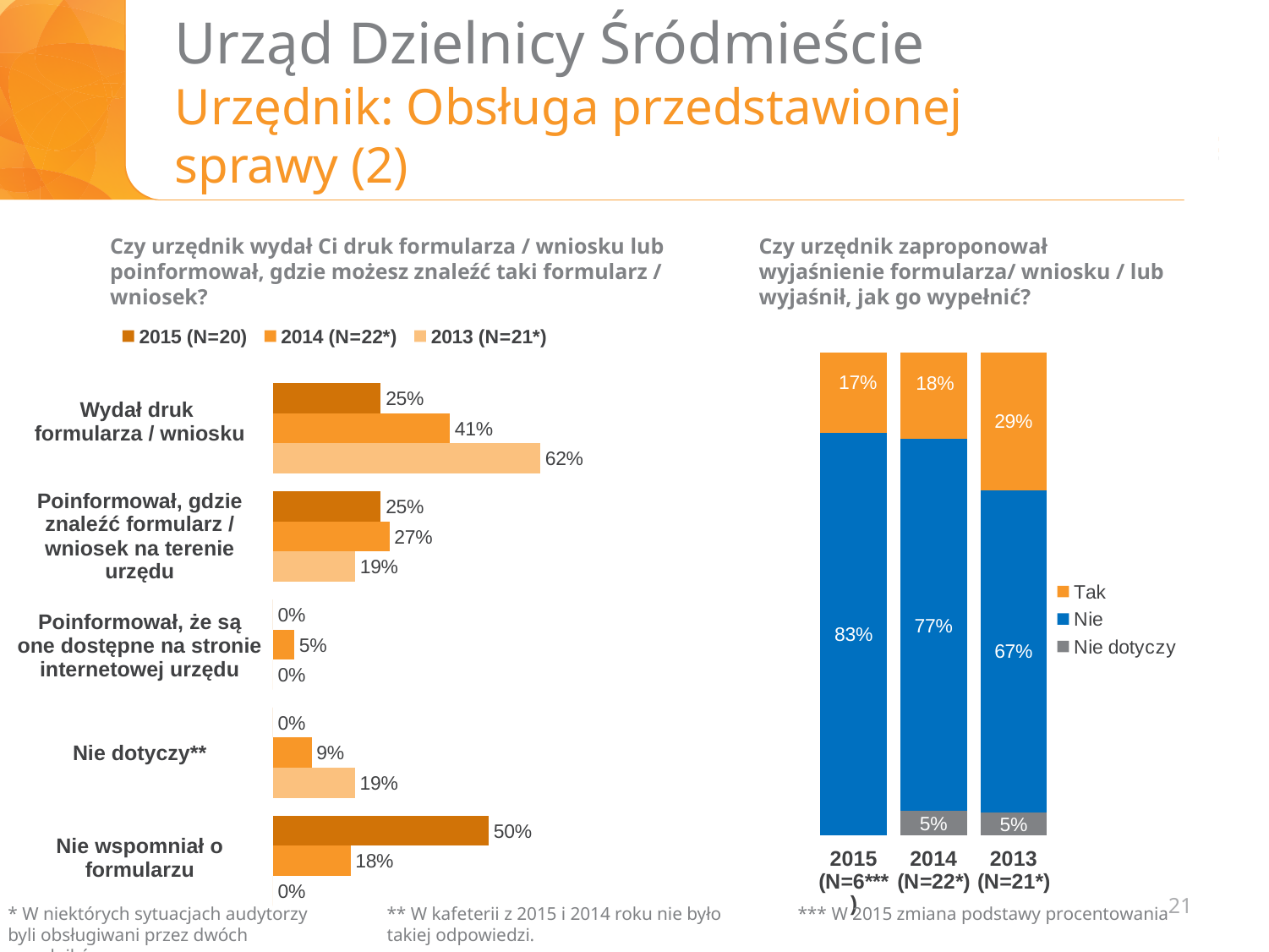
In the right chart, what is the "Nie" share for 2015? 83% In the left chart, what is the difference between the 2013 and 2015 values for "Wydał druk formularza / wniosku"? 37% In the left chart, which category has the highest 2013 value? Wydał druk formularza / wniosku In the right chart, what is the "Nie dotyczy" share for 2014? 5% In the left chart, what is the 2014 value for "Poinformował, gdzie znaleźć formularz / wniosek na terenie urzędu"? 27% What kind of chart is the left chart? Bar chart In the right chart, what is the "Tak" share for 2013? 29% In the left chart, what is the 2013 value for "Wydał druk formularza / wniosku"? 62% In the left chart, how many categories are shown? 5 In the left chart, how many series does the legend list? 3 In the left chart, what is the 2015 value for "Nie wspomniał o formularzu"? 50% In the right chart, which year has the lowest "Nie" share? 2013